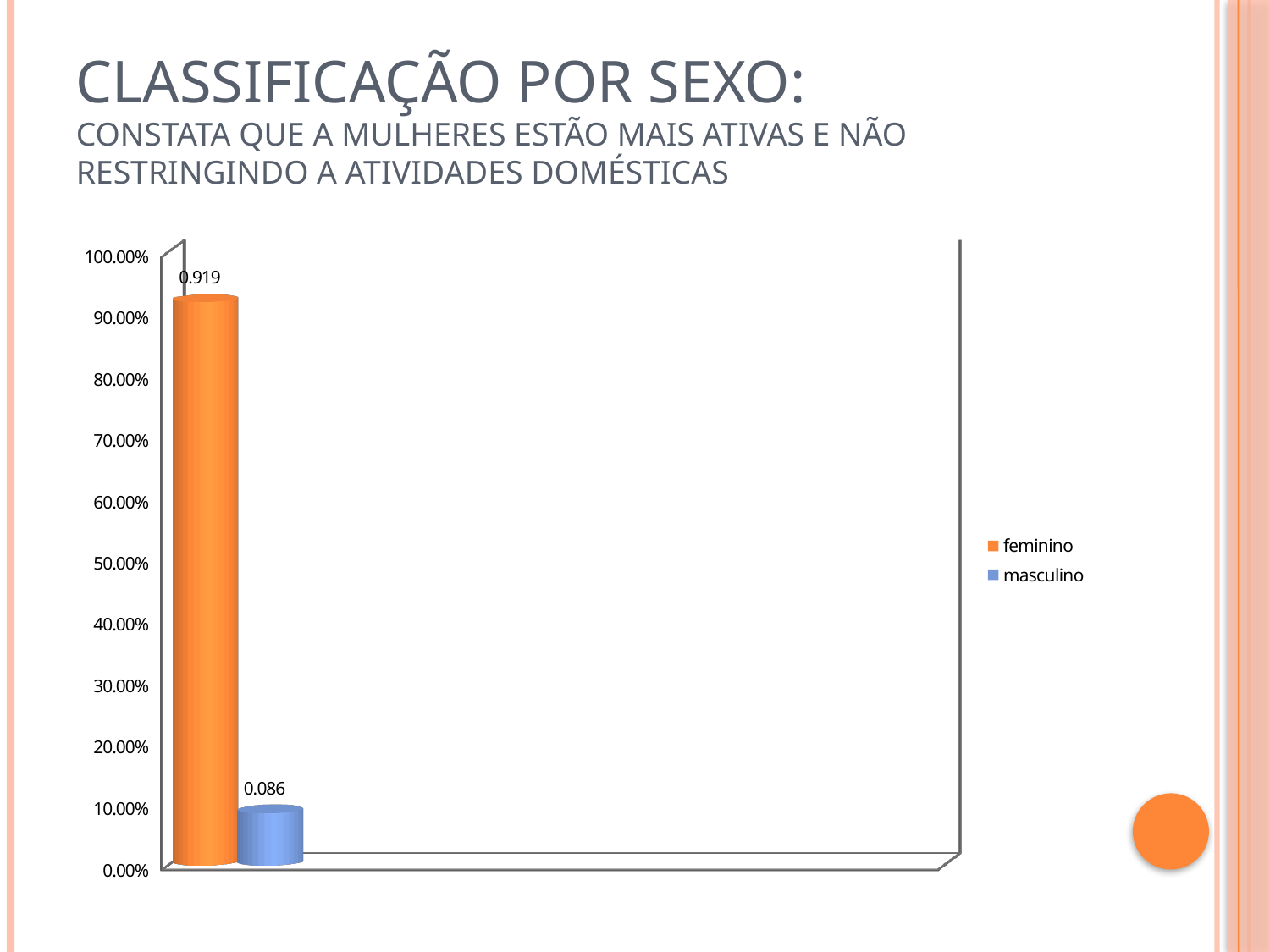
Which series has the highest value? feminino Is the bar for feminino greater or less than 90.00%? greater What is the value shown for masculino? 0.086 What kind of chart is shown on the slide? bar chart Which is larger, the value for feminino or the value for masculino? feminino Which series has the lowest value? masculino How many series does the legend list? 2 What is the highest value shown on the vertical axis? 100.00% Is the bar for masculino greater or less than 10.00%? less What is the value shown for feminino? 0.919 What is the difference between the feminino and masculino values? 0.833 What colour is the bar for feminino? orange